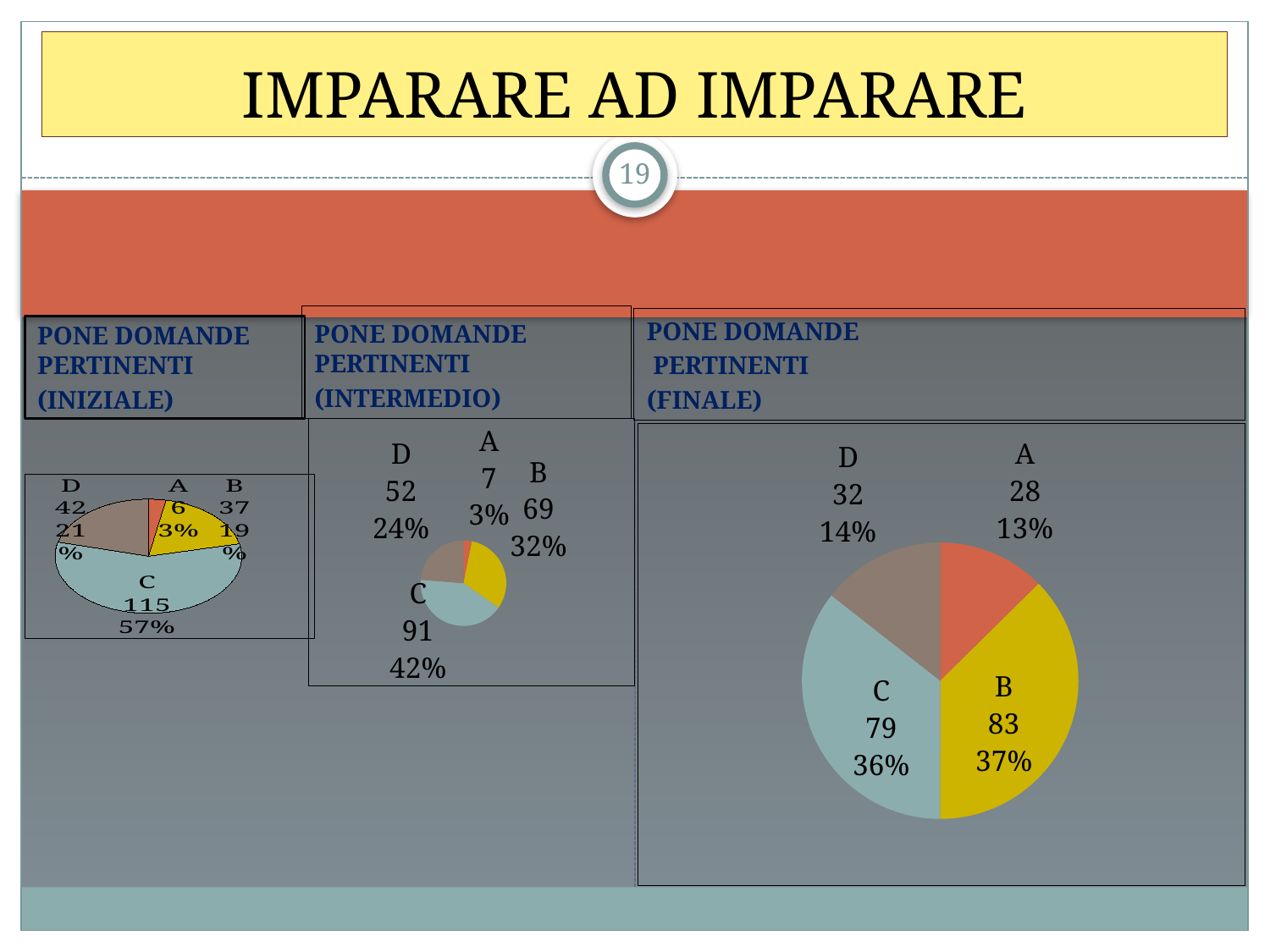
In the PONE DOMANDE PERTINENTI (FINALE) pie chart, which is larger, the value for A or the value for D? D In the PONE DOMANDE PERTINENTI (FINALE) pie chart, what is the difference between the values for B and C? 4 In the PONE DOMANDE PERTINENTI (FINALE) pie chart, what percentage share does category D have? 14% In the PONE DOMANDE PERTINENTI (INIZIALE) pie chart, which category has the largest slice? C What type of chart is used in the PONE DOMANDE PERTINENTI (INTERMEDIO) panel? Pie chart In the PONE DOMANDE PERTINENTI (INTERMEDIO) pie chart, which category has the smallest slice? A In the PONE DOMANDE PERTINENTI (FINALE) pie chart, what is the value for category B? 83 In the PONE DOMANDE PERTINENTI (INIZIALE) pie chart, what is the value for category C? 115 In the PONE DOMANDE PERTINENTI (INTERMEDIO) pie chart, what is the value for category C? 91 In the PONE DOMANDE PERTINENTI (INTERMEDIO) pie chart, what is the difference between the values for C and D? 39 In the PONE DOMANDE PERTINENTI (INTERMEDIO) pie chart, what percentage share does category B have? 32% How many categories does the PONE DOMANDE PERTINENTI (FINALE) pie chart show? 4